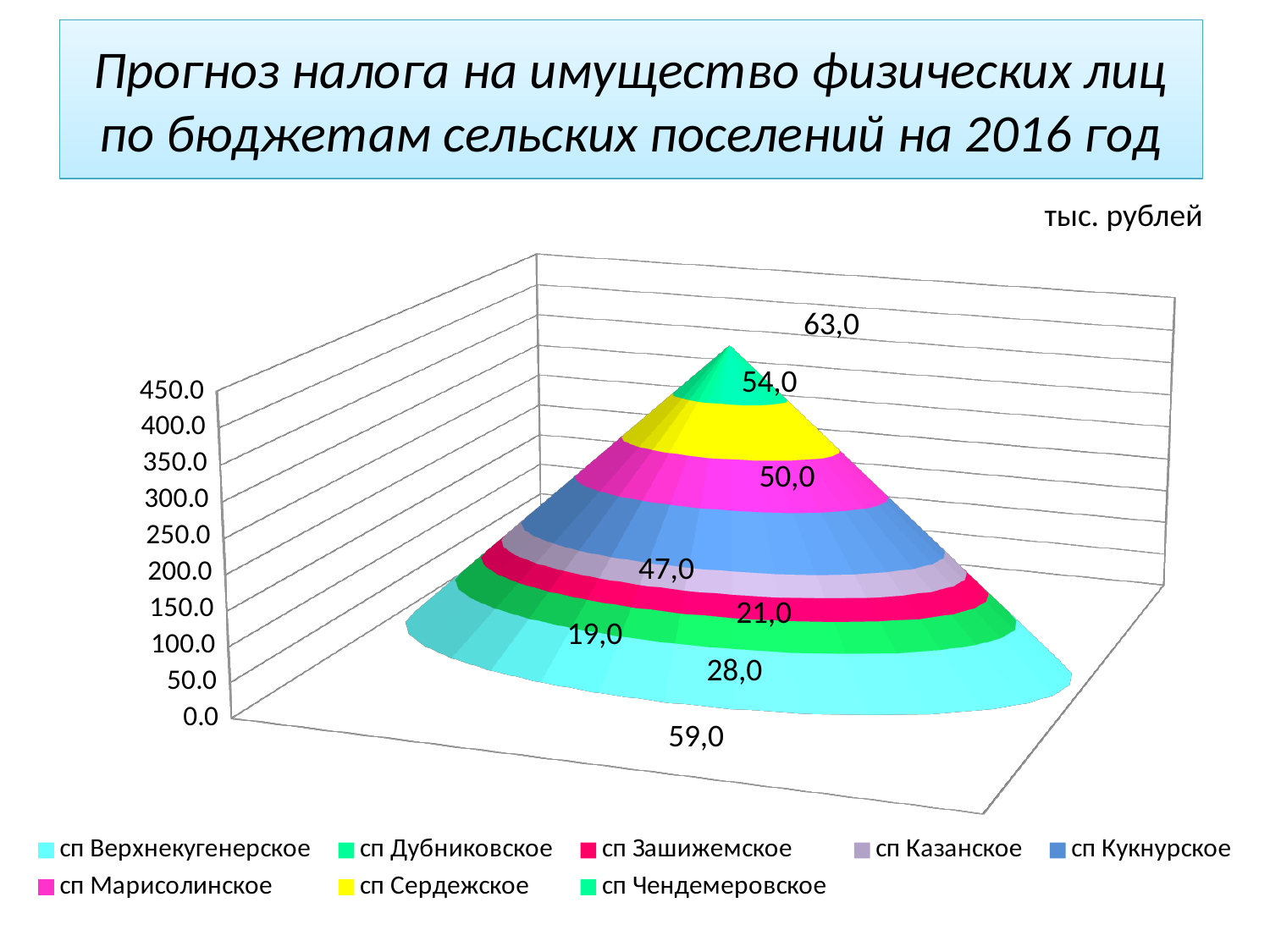
Which is larger, the value for сп Дубниковское or сп Зашижемское? сп Дубниковское What unit is stated above the chart? тыс. рублей Which settlement has the lowest value? сп Зашижемское What is the value for сп Чендемеровское? 63,0 What is the difference between the values for сп Чендемеровское and сп Казанское? 42,0 What is the value for сп Верхнекугенерское? 59,0 How many series does the legend list? 8 What is the value for сп Марисолинское? 50,0 What is the total of all the stacked segments? 341,0 What is the value for сп Сердежское? 54,0 What is the value for сп Кукнурское? 47,0 Which settlement has the highest value? сп Чендемеровское